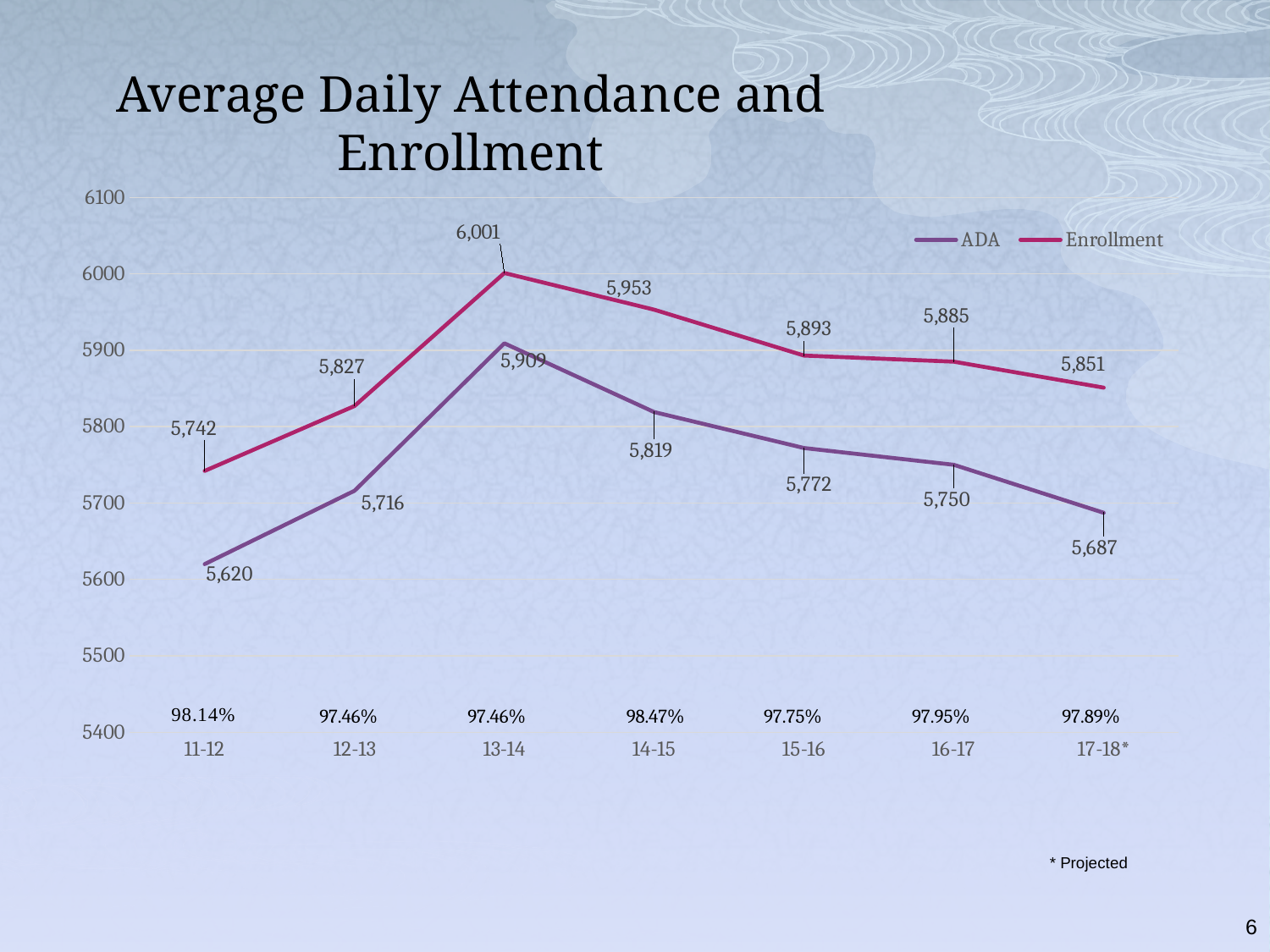
What is the Enrollment value for 13-14? 6,001 How many series does the legend list? 2 Is the Enrollment value for 12-13 greater or less than 5800? greater Which is larger, the ADA value for 13-14 or the ADA value for 14-15? 13-14 What kind of chart is shown? line chart What is the ADA value for 17-18*? 5,687 Does the ADA line rise or fall from 13-14 to 17-18*? fall What is the difference between Enrollment and ADA in 15-16? 121 Which year has the lowest ADA? 11-12 How many years are shown on the x axis? 7 What is the ADA value for 11-12? 5,620 Which year has the highest Enrollment? 13-14